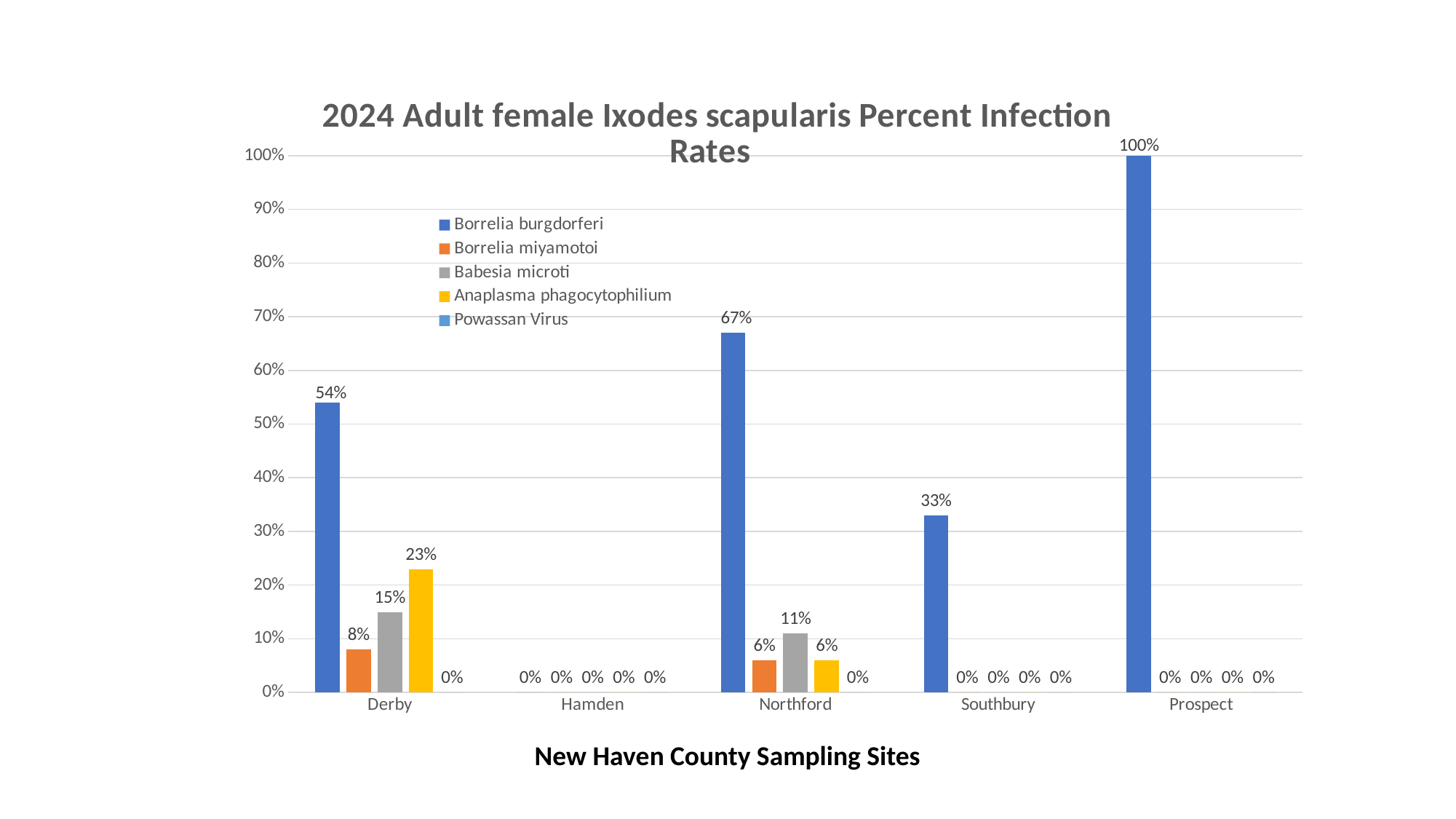
What is the Borrelia burgdorferi infection rate at Southbury? 33% What kind of chart is shown on the slide? Bar chart Which sampling site has the highest Borrelia burgdorferi infection rate? Prospect How many sampling sites are shown on the x axis? 5 What is the difference between the Borrelia burgdorferi infection rates at Northford and Derby? 13% What is the Anaplasma phagocytophilium infection rate at Derby? 23% Which sampling site has the lowest Borrelia burgdorferi infection rate? Hamden What is the x-axis title of the chart? New Haven County Sampling Sites What is the Borrelia burgdorferi infection rate at Derby? 54% How many series does the legend list? 5 What is the Babesia microti infection rate at Northford? 11% Which is larger, the Babesia microti rate at Derby or at Northford? Derby